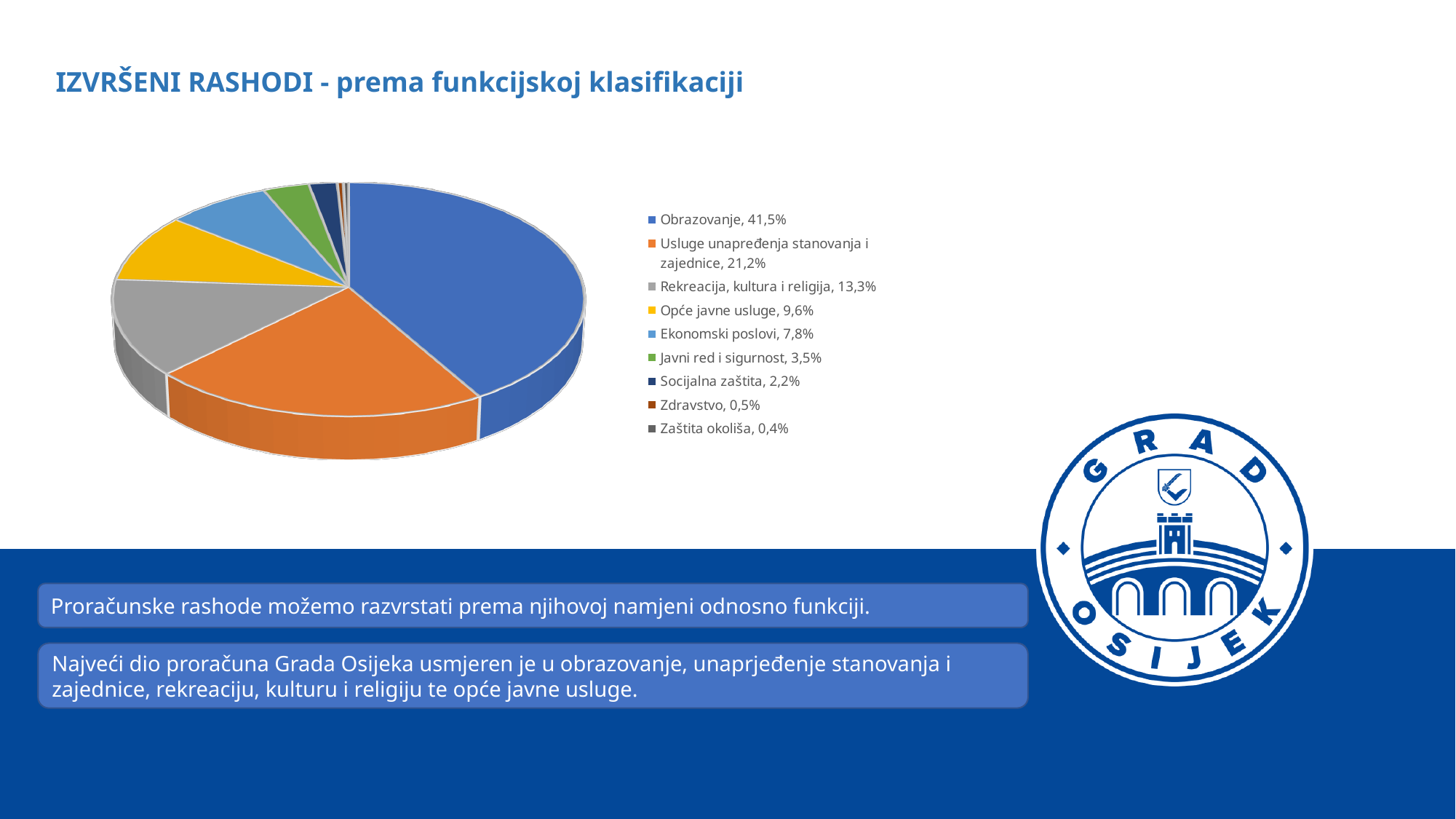
What is the value for Ekonomski poslovi? 7,8% What is the difference between the shares of Javni red i sigurnost and Zdravstvo? 3,0% What is the difference between the shares of Obrazovanje and Usluge unapređenja stanovanja i zajednice? 20,3% What is the value for Rekreacija, kultura i religija? 13,3% Which is larger, Opće javne usluge or Ekonomski poslovi? Opće javne usluge What share of the pie does Obrazovanje have? 41,5% How many categories does the pie chart have? 9 What is the value for Socijalna zaštita? 2,2% Which category has the smallest share of the pie? Zaštita okoliša Which category has the largest share of the pie? Obrazovanje What kind of chart is shown on the slide? Pie chart What colour is the slice for Opće javne usluge? Yellow